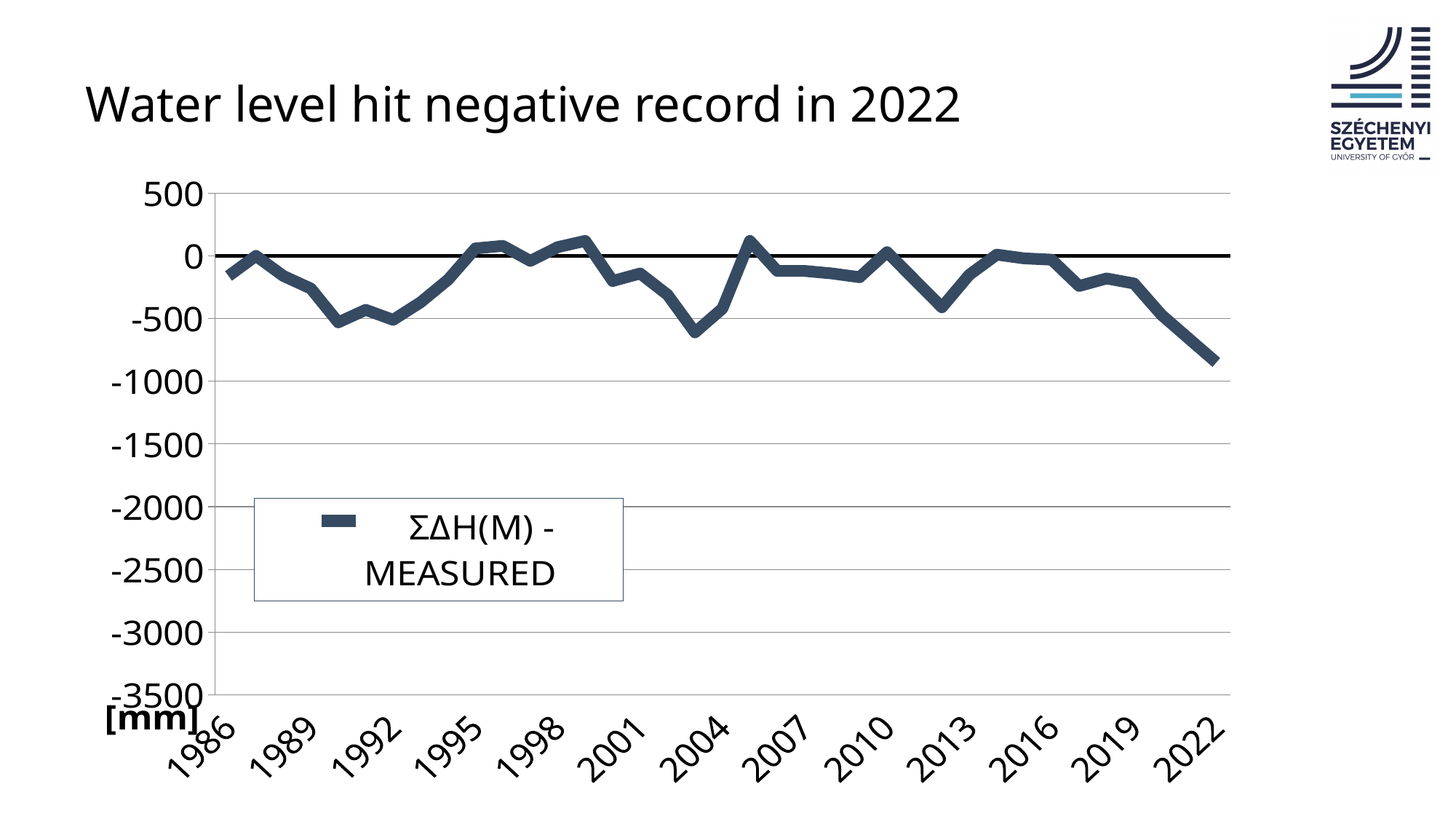
Is the value for 2019 greater or less than -500? greater What is the name of the series shown in the legend? ΣΔH(M) - MEASURED Do the values rise or fall from 2016 to 2022? fall Which is larger, the value for 2004 or the value for 2007? 2007 Which is larger, the value for 1986 or the value for 2022? 1986 Is the value for 2022 greater or less than -500? less In which year does the line reach its lowest value? 2022 What kind of chart is shown on the slide? line chart How many series does the legend list? 1 Is the value for 1986 greater or less than 0? less What unit is shown for the y axis? [mm]